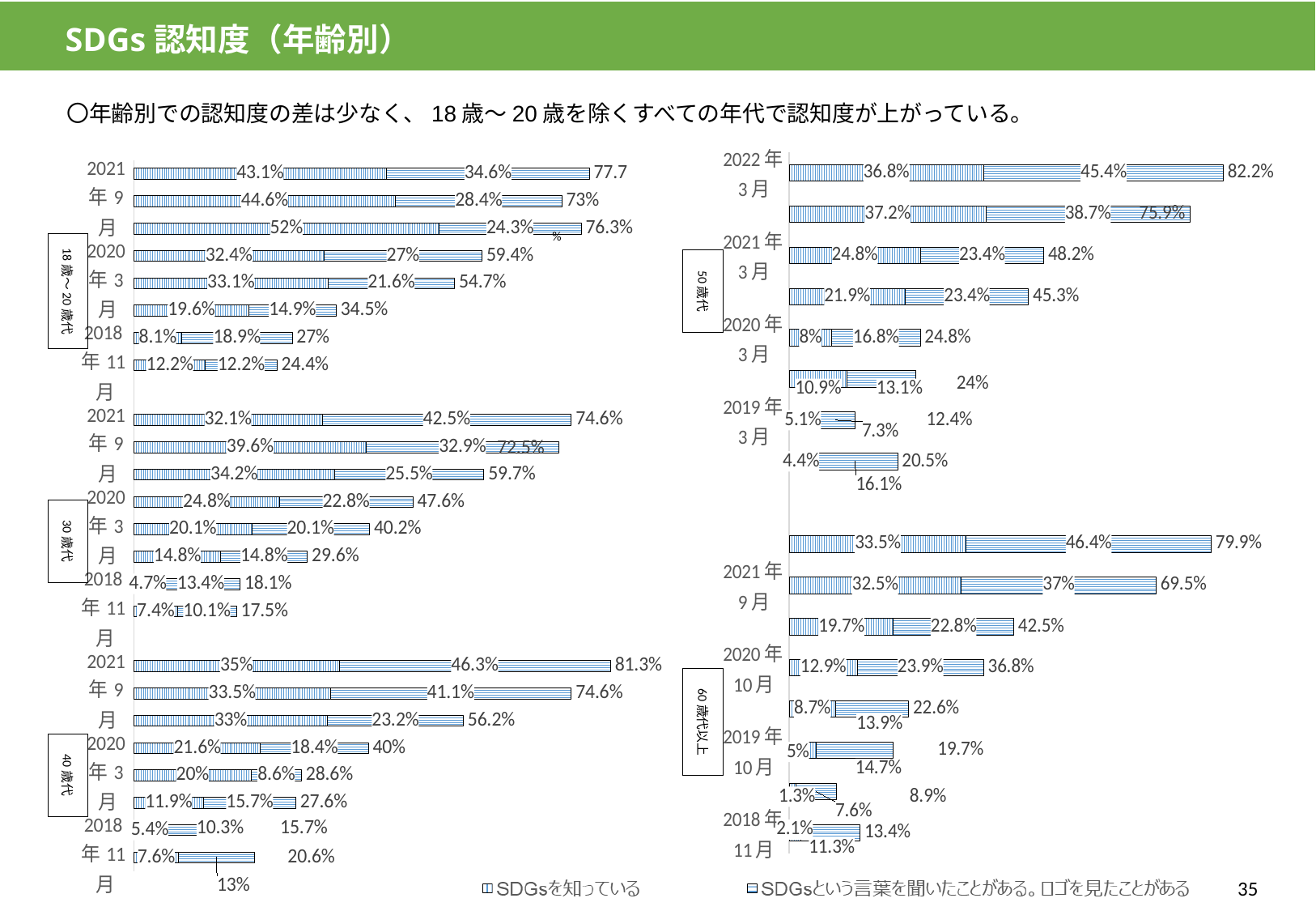
In the left chart, what is the sum of the two segments of the topmost bar in the 30歳代 group (32.1% and 42.5%)? 74.6% How many series does the legend at the bottom of the slide list? 2 In the right chart, what is the total label on the topmost bar of the 50歳代 group? 82.2% In the right chart, what is the 'SDGsを知っている' value on the topmost bar of the 60歳代以上 group? 33.5% In the left chart, what is the difference between the total of the topmost bar in the 40歳代 group (81.3%) and the total of the topmost bar in the 30歳代 group (74.6%)? 6.7% What is the title of the slide? SDGs 認知度（年齢別） In the left chart, what is the total label on the topmost bar of the 40歳代 group? 81.3% In the right chart, which is larger: the total of the topmost bar in the 50歳代 group or the total of the topmost bar in the 60歳代以上 group? 50歳代 (82.2%) In the right chart, what is the lowest total value shown in the 60歳代以上 group? 8.9% In the left chart, what is the 'SDGsを知っている' value on the topmost bar of the 18歳～20歳代 group? 43.1% What kind of chart is used on the left side of the slide? bar chart In the left chart, which age group contains the bar with the highest total value? 40歳代